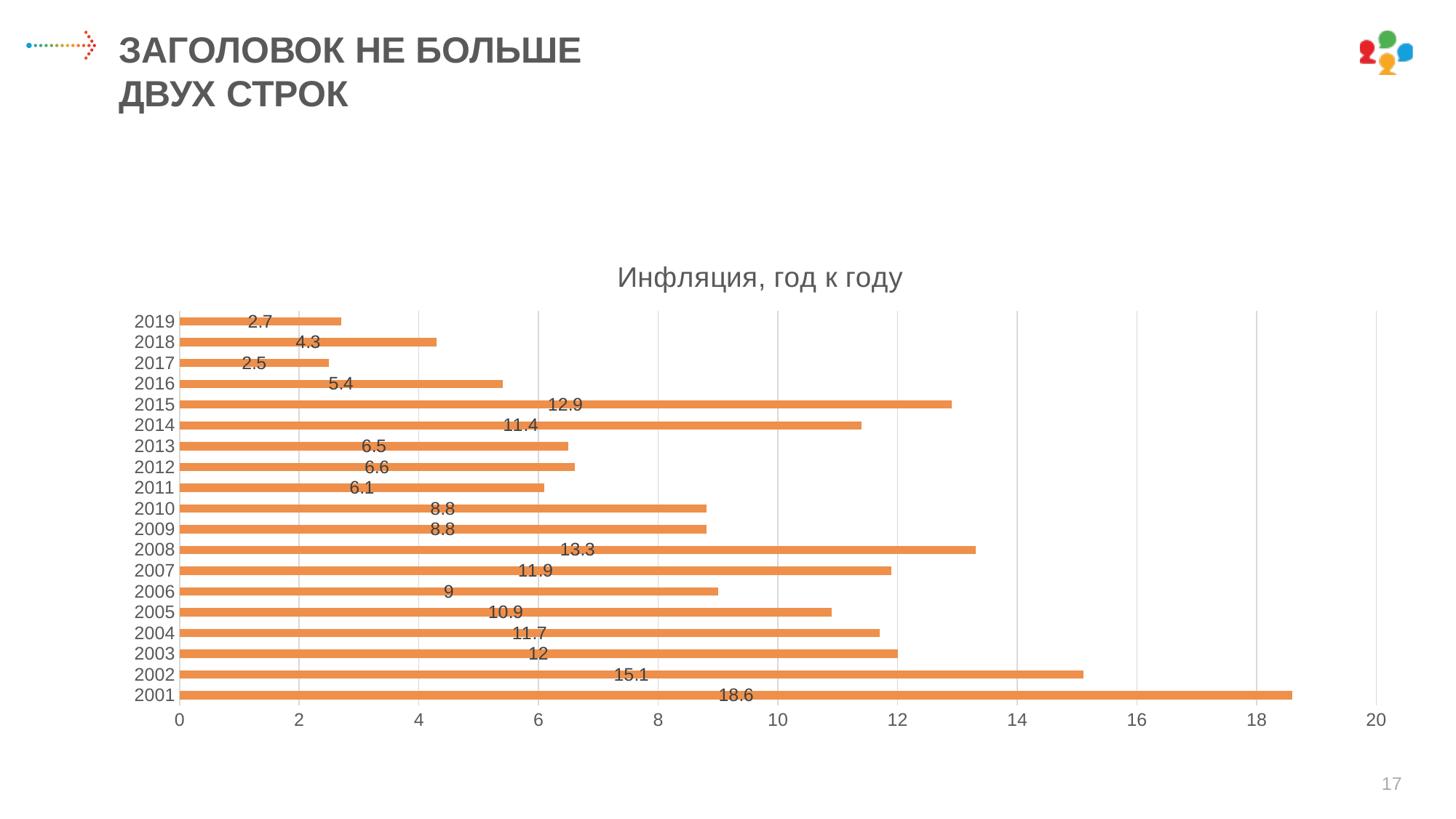
How many years are shown in the chart? 19 What is the difference between the values for 2018 and 2017? 1.8 Which year has the lowest value? 2017 Which year has the highest value? 2001 What is the value for 2019? 2.7 Is the value for 2014 greater or less than 10? greater Which is larger, the value for 2008 or the value for 2015? 2008 What kind of chart is shown? bar chart What is the title of the chart? Инфляция, год к году What is the difference between the values for 2001 and 2002? 3.5 What is the value for 2015? 12.9 What is the value for 2006? 9